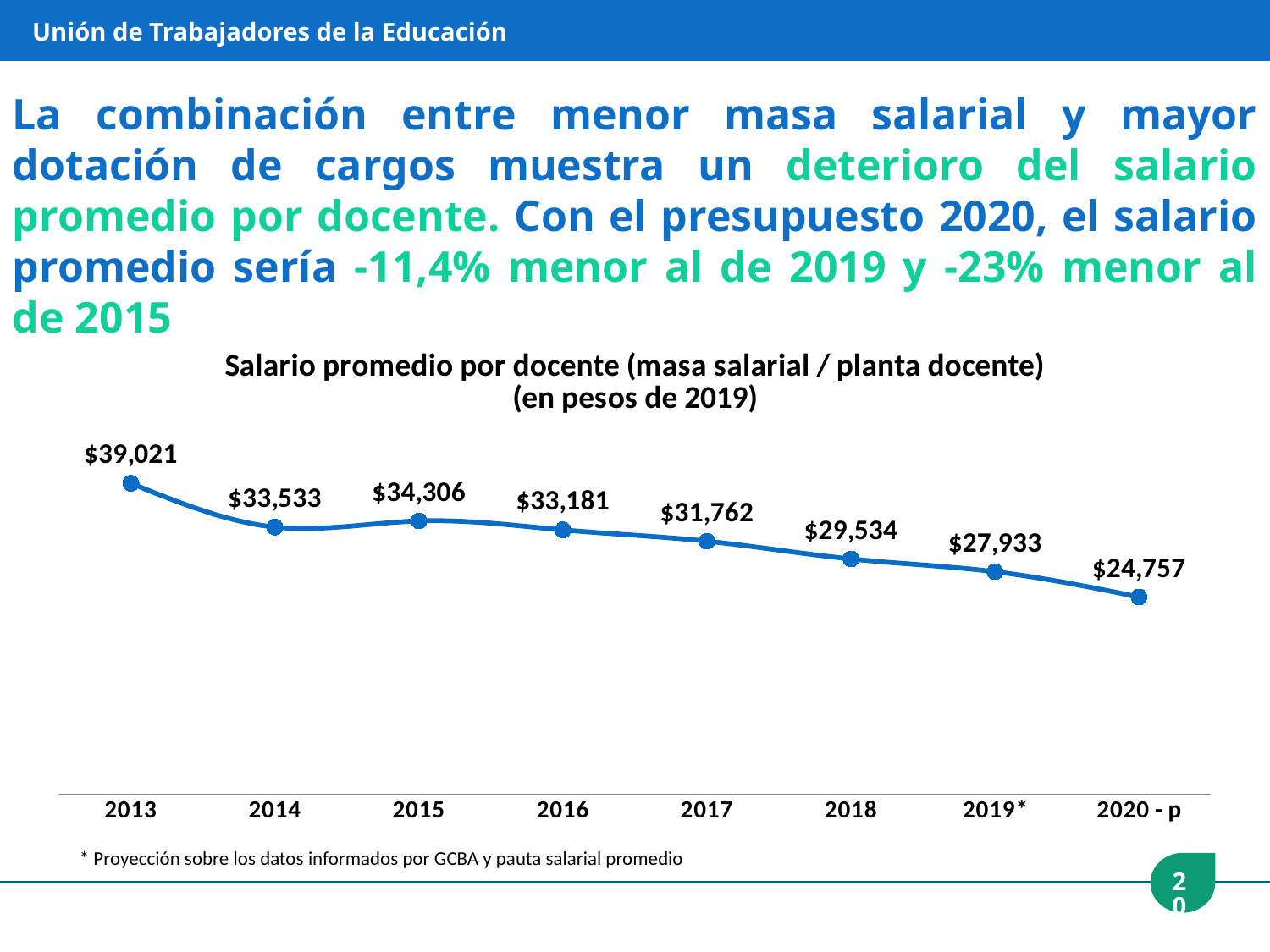
Which is larger, the value for 2015 or the value for 2016? 2015 What kind of chart is shown on the slide? Line chart What value is plotted for 2020 - p? $24,757 How many years are plotted on the chart? 8 What is the difference between the 2013 value and the 2020 - p value? $14,264 What is the value shown for 2017? $31,762 What is the value shown for 2019*? $27,933 Which year has the lowest average salary per teacher? 2020 - p Do the values generally rise or fall from 2013 to 2020 - p? Fall Which year has the highest average salary per teacher? 2013 What is the average salary per teacher shown for 2013? $39,021 What is the difference between the 2015 value and the 2014 value? $773